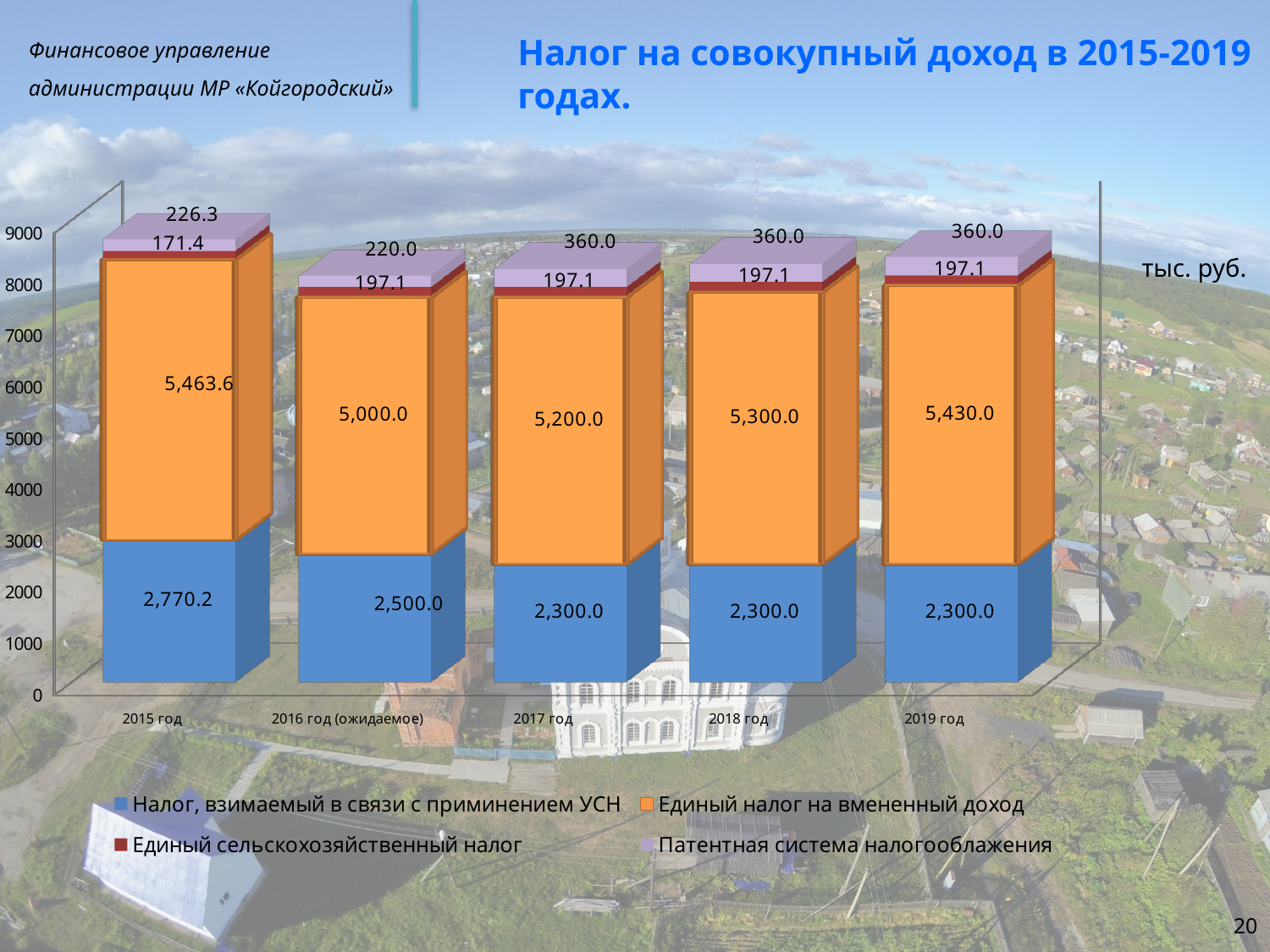
Which is larger: 'Патентная система налогооблажения' in 2015 год or in 2017 год? 2017 год How many year categories are shown on the x axis? 5 What is the value of 'Патентная система налогооблажения' for 2019 год? 360.0 What is the value of 'Единый сельскохозяйственный налог' for 2015 год? 171.4 What is the value of 'Налог, взимаемый в связи с приминением УСН' for 2016 год (ожидаемое)? 2,500.0 In which year is the value of 'Налог, взимаемый в связи с приминением УСН' the highest? 2015 год What is the value of 'Единый налог на вмененный доход' for 2015 год? 5,463.6 What is the total of the stacked bar for 2016 год (ожидаемое)? 7,917.1 In which year is the value of 'Единый налог на вмененный доход' the lowest? 2016 год (ожидаемое) What is the difference between the 'Единый налог на вмененный доход' values for 2019 год and 2018 год? 130.0 What type of chart is shown on the slide? Bar chart How many series does the legend list? 4